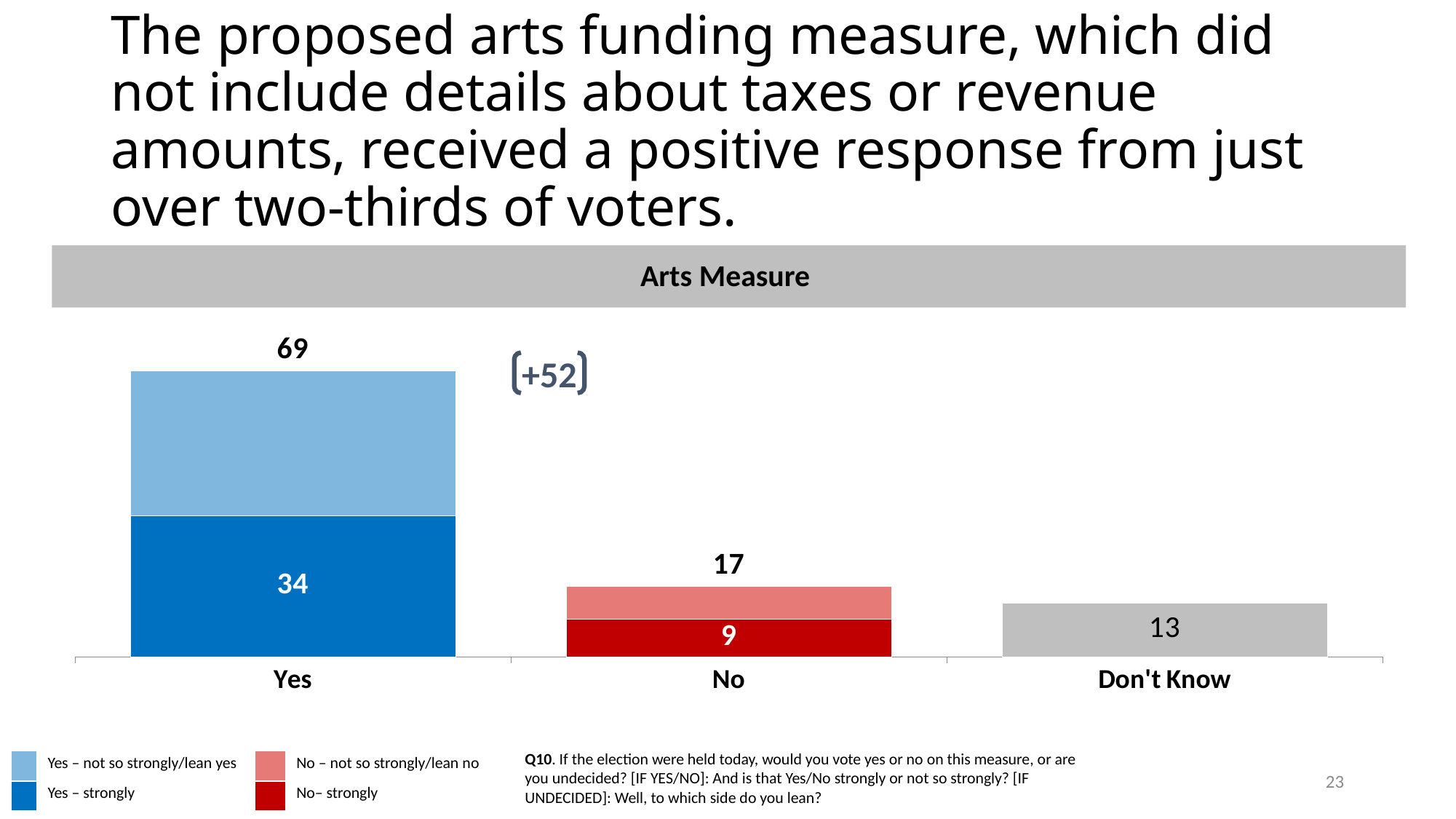
What is the total value of the Yes bar? 69 Which is larger, the No total or the Don't Know value? No How many entries does the legend list? 4 What is the total value of the No bar? 17 How many categories are shown on the x axis? 3 What is the value for 'Yes – strongly'? 34 What is the difference between the Yes total and the No total? 52 What is the value for 'No– strongly'? 9 Which category has the lowest total value? Don't Know What is the title of the chart? Arts Measure Which category has the highest total value? Yes What is the value for Don't Know? 13